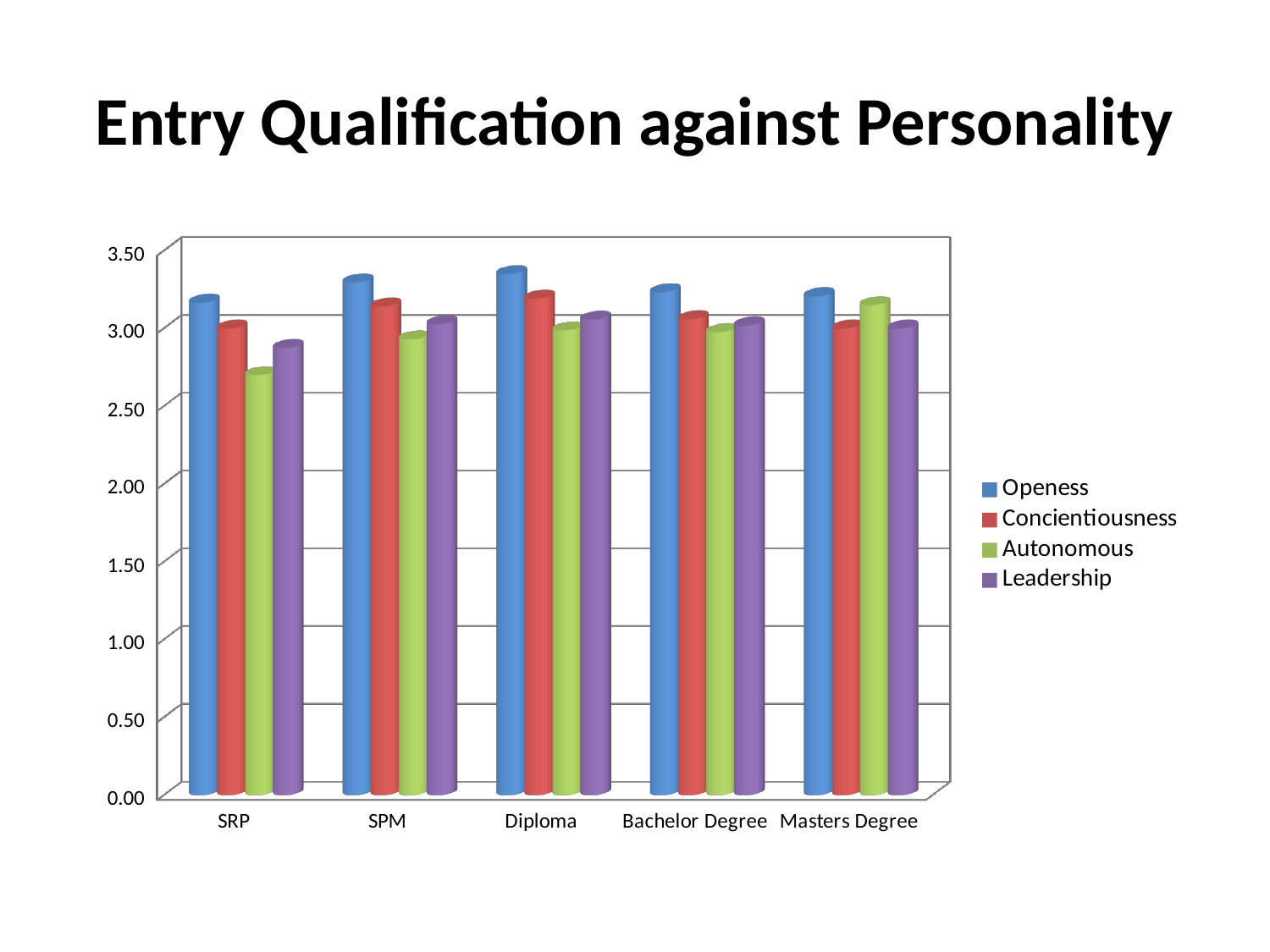
What is the title of the chart? Entry Qualification against Personality For SRP, which series has the highest value? Openess Is the Autonomous value for SRP greater or less than 3.00? less Is the Leadership value for SRP greater or less than 3.00? less Which is larger, the Autonomous value for SRP or the Autonomous value for Masters Degree? Masters Degree Is the Openess value for Diploma greater or less than 3.00? greater How many series does the legend list? 4 Which series is shown in green in the legend? Autonomous What kind of chart is shown on the slide? bar chart For SRP, which series has the lowest value? Autonomous How many entry qualification categories are shown on the x axis? 5